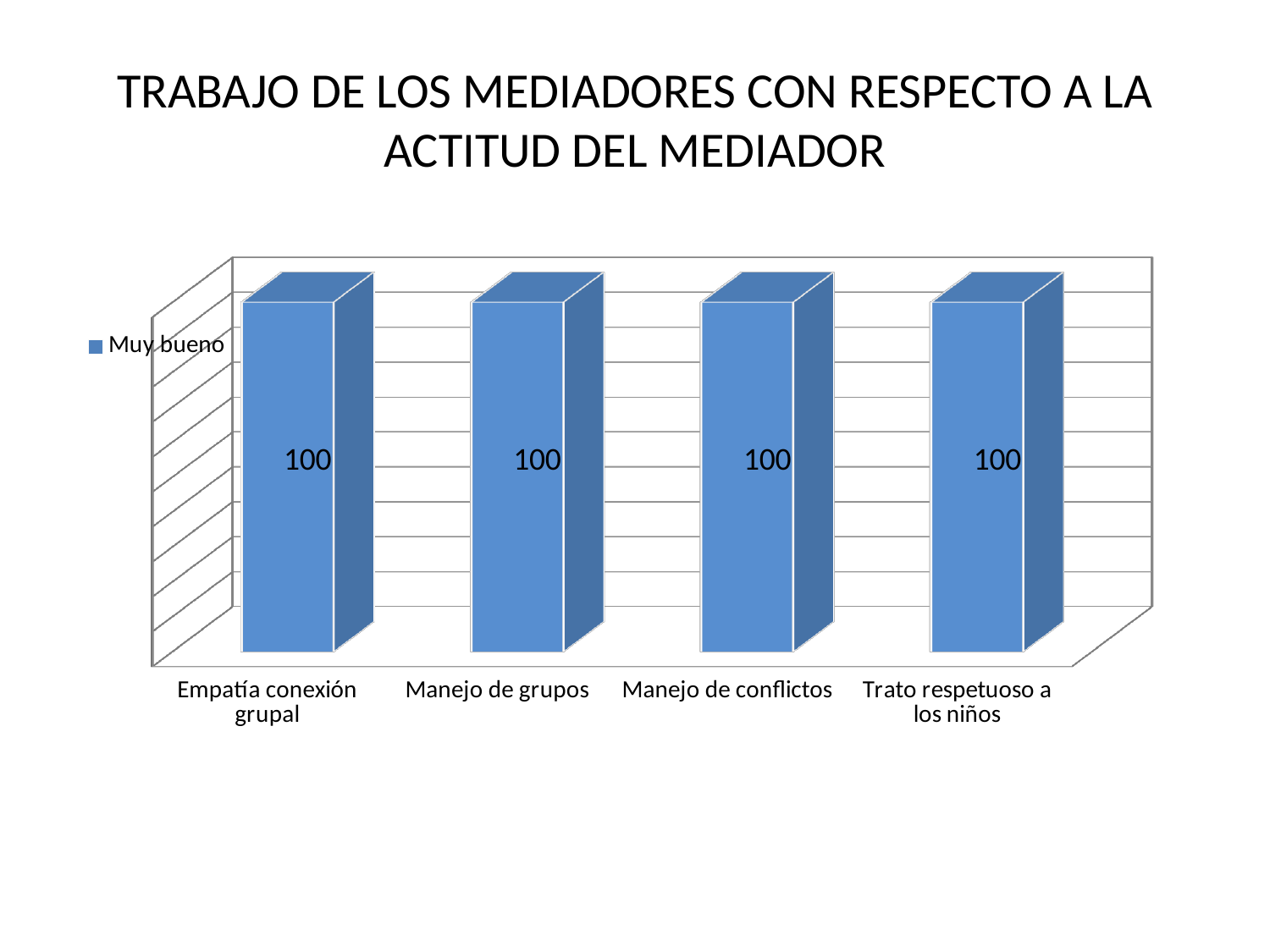
What kind of chart is shown on the slide? Bar chart What is the difference between the values for Manejo de grupos and Manejo de conflictos? 0 What is the value for Manejo de conflictos? 100 What is the value for Empatía conexión grupal? 100 What is the title of the chart? TRABAJO DE LOS MEDIADORES CON RESPECTO A LA ACTITUD DEL MEDIADOR What is the value for Manejo de grupos? 100 What is the value for Trato respetuoso a los niños? 100 What is the name of the series listed in the legend? Muy bueno How many categories are shown on the x axis? 4 How many series does the legend list? 1 Do the values rise, fall or stay the same across the categories from left to right? Stay the same